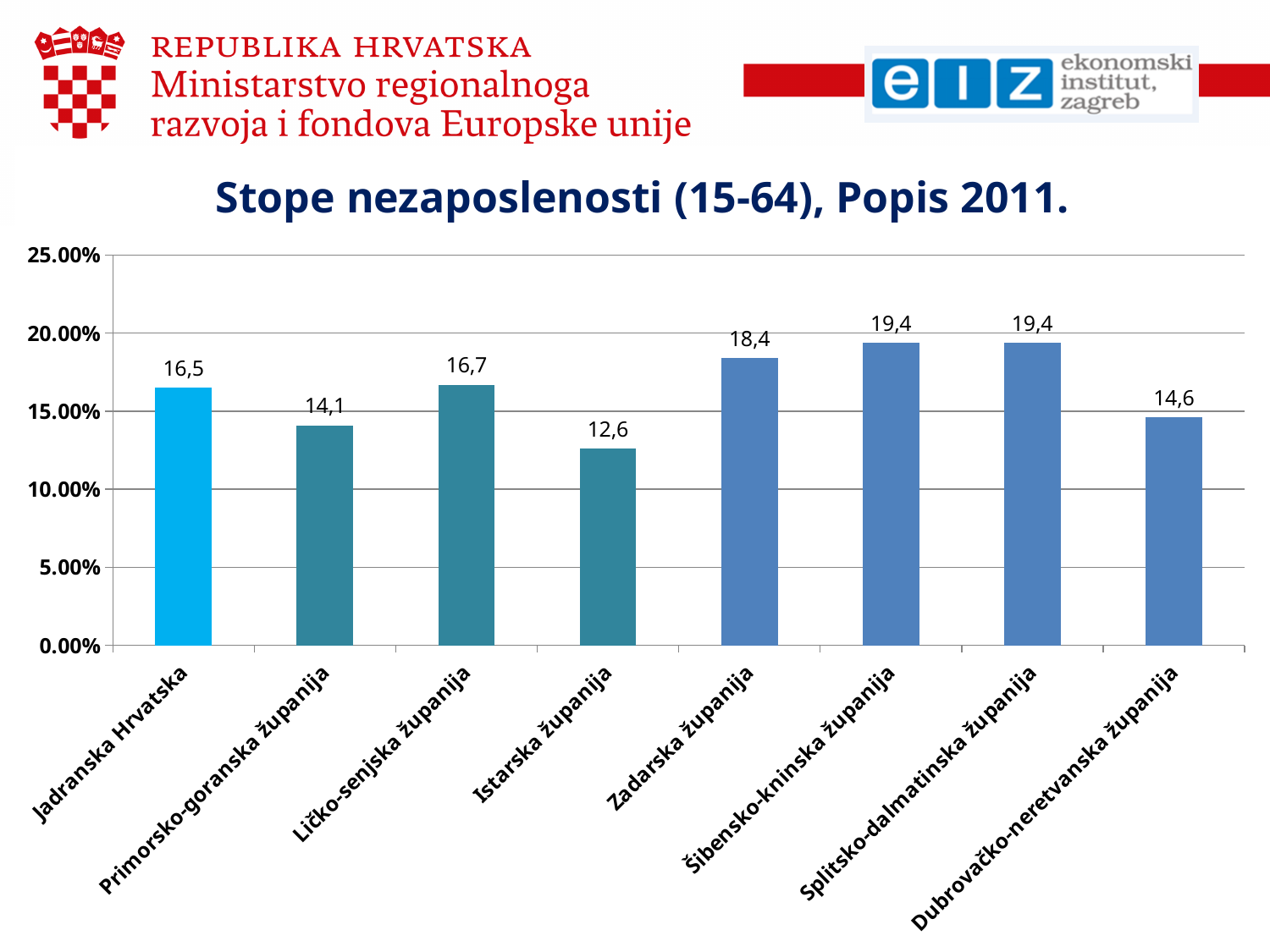
How many categories are shown on the x axis? 8 What is the value shown for Zadarska županija? 18,4 Is the value for Splitsko-dalmatinska županija greater or less than 15.00%? greater What is the difference between the values for Ličko-senjska županija and Primorsko-goranska županija? 2,6 What is the value shown for Jadranska Hrvatska? 16,5 What kind of chart is shown on the slide? bar chart Which category has the lowest value? Istarska županija What is the value shown for Istarska županija? 12,6 What is the difference between the values for Šibensko-kninska županija and Istarska županija? 6,8 What is the value shown for Dubrovačko-neretvanska županija? 14,6 Which is larger, the value for Zadarska županija or the value for Dubrovačko-neretvanska županija? Zadarska županija What is the title of the chart? Stope nezaposlenosti (15-64), Popis 2011.